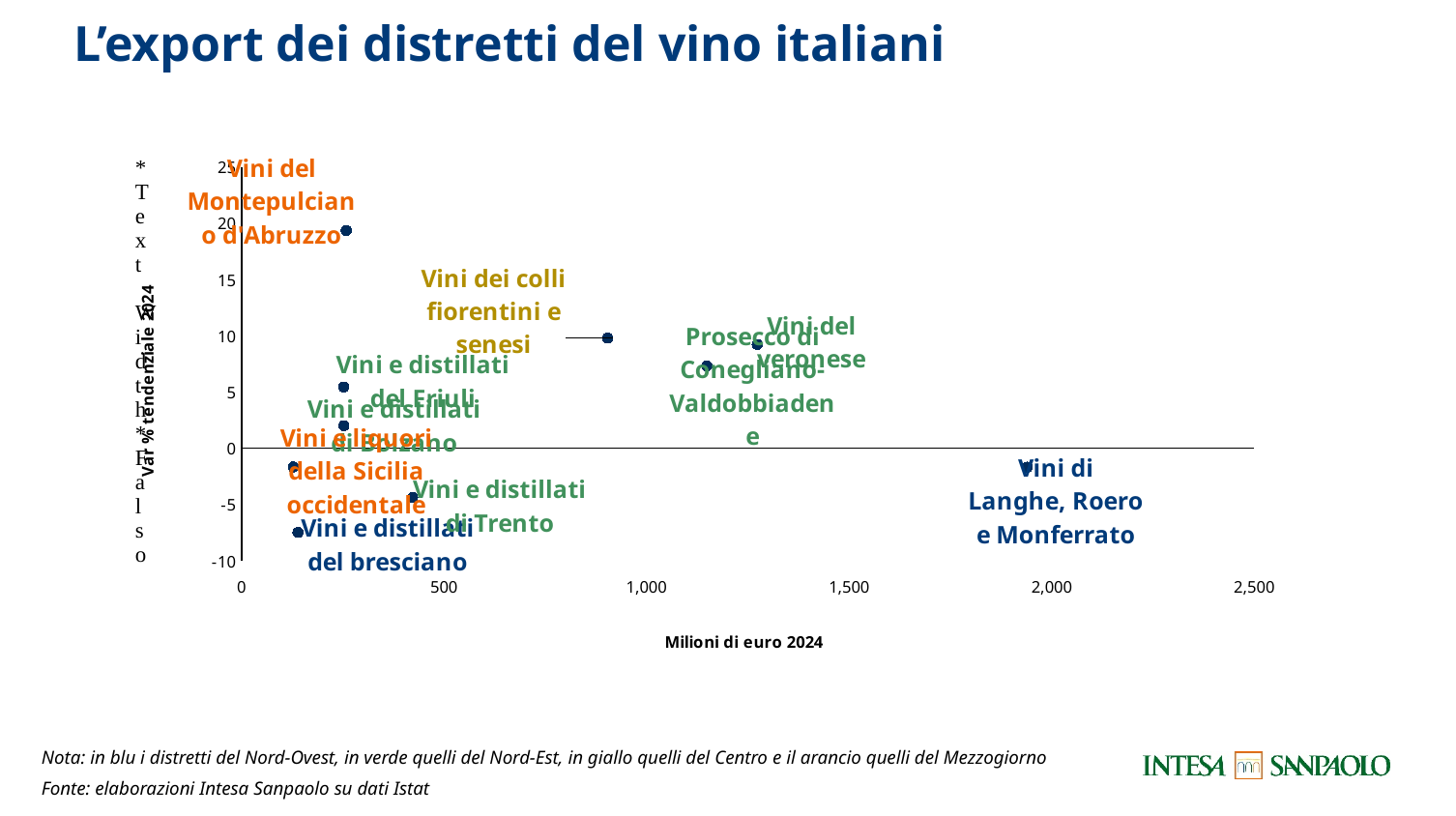
What kind of chart is shown on the slide? scatter chart What is the label of the horizontal axis of the chart? Milioni di euro 2024 Is the Var % tendenziale 2024 for Vini del Montepulciano d'Abruzzo greater or less than 15? greater Which district has the highest value on the vertical axis (Var % tendenziale 2024)? Vini del Montepulciano d'Abruzzo Is the export value (Milioni di euro 2024) for Vini dei colli fiorentini e senesi greater or less than 500? greater Which district has the highest export value on the horizontal axis (Milioni di euro 2024)? Vini di Langhe, Roero e Monferrato According to the note, which colour is used for the districts of the Nord-Ovest? blu Which has a larger export value in Milioni di euro 2024: Prosecco di Conegliano-Valdobbiadene or Vini di Langhe, Roero e Monferrato? Vini di Langhe, Roero e Monferrato Is the Var % tendenziale 2024 for Vini e distillati del bresciano greater or less than -5? less Which district has the lowest value on the vertical axis (Var % tendenziale 2024)? Vini e distillati del bresciano How many wine districts are plotted on the chart? 10